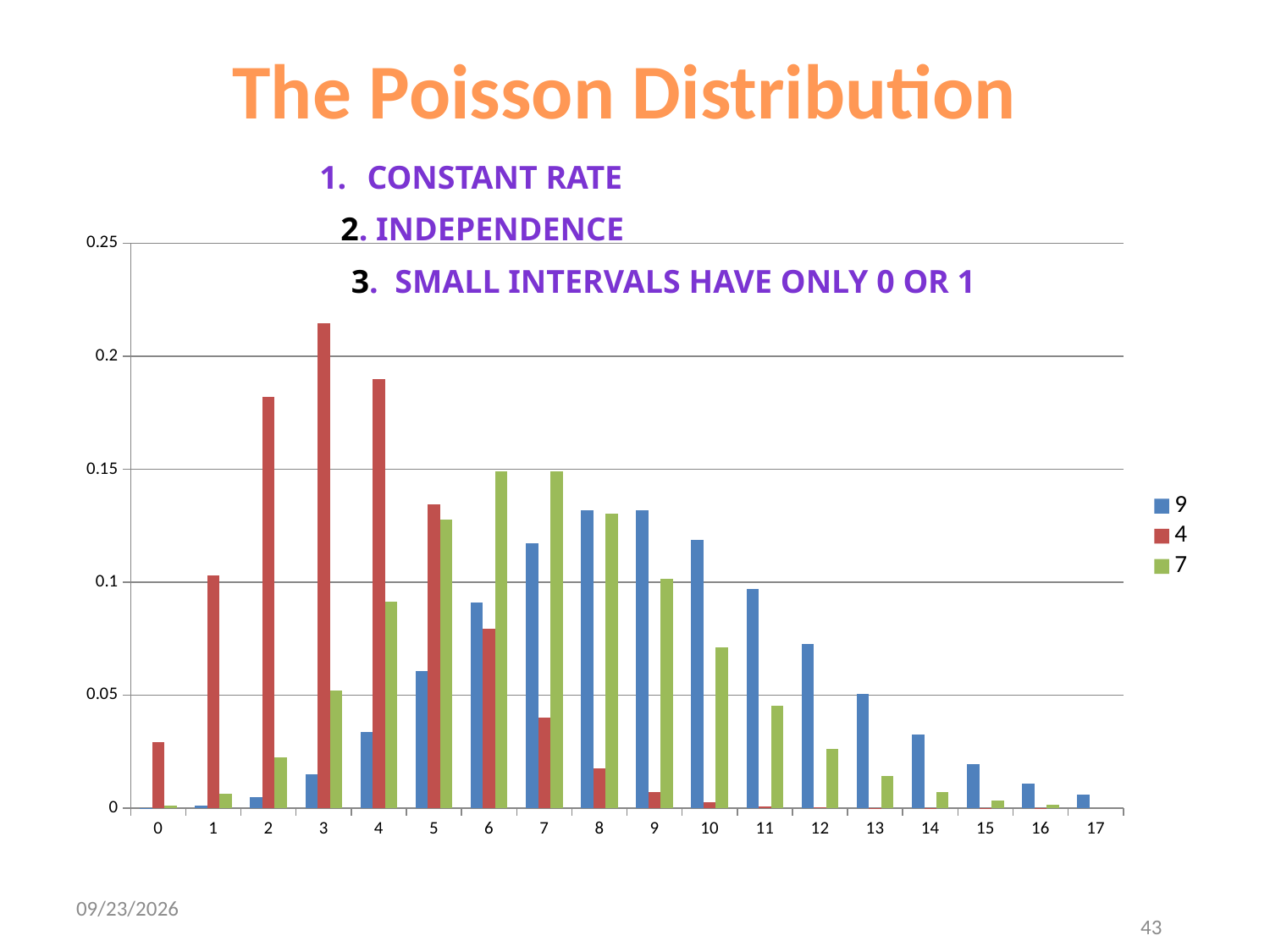
Which series has the tallest bar in the chart? 4 Is the value for series 4 at category 2 greater or less than 0.2? less How many categories are shown along the x axis? 18 At which x-axis category does series 4 reach its highest value? 3 What colour are the bars for series 4 in the legend? red How many series does the legend list? 3 Do the values for series 9 rise or fall from category 9 to category 17? fall What kind of chart is shown on the slide? bar chart Is the value for series 7 at category 11 greater or less than 0.05? less Is the value for series 4 at category 3 greater or less than 0.2? greater At category 6, which series has the larger value, 7 or 9? 7